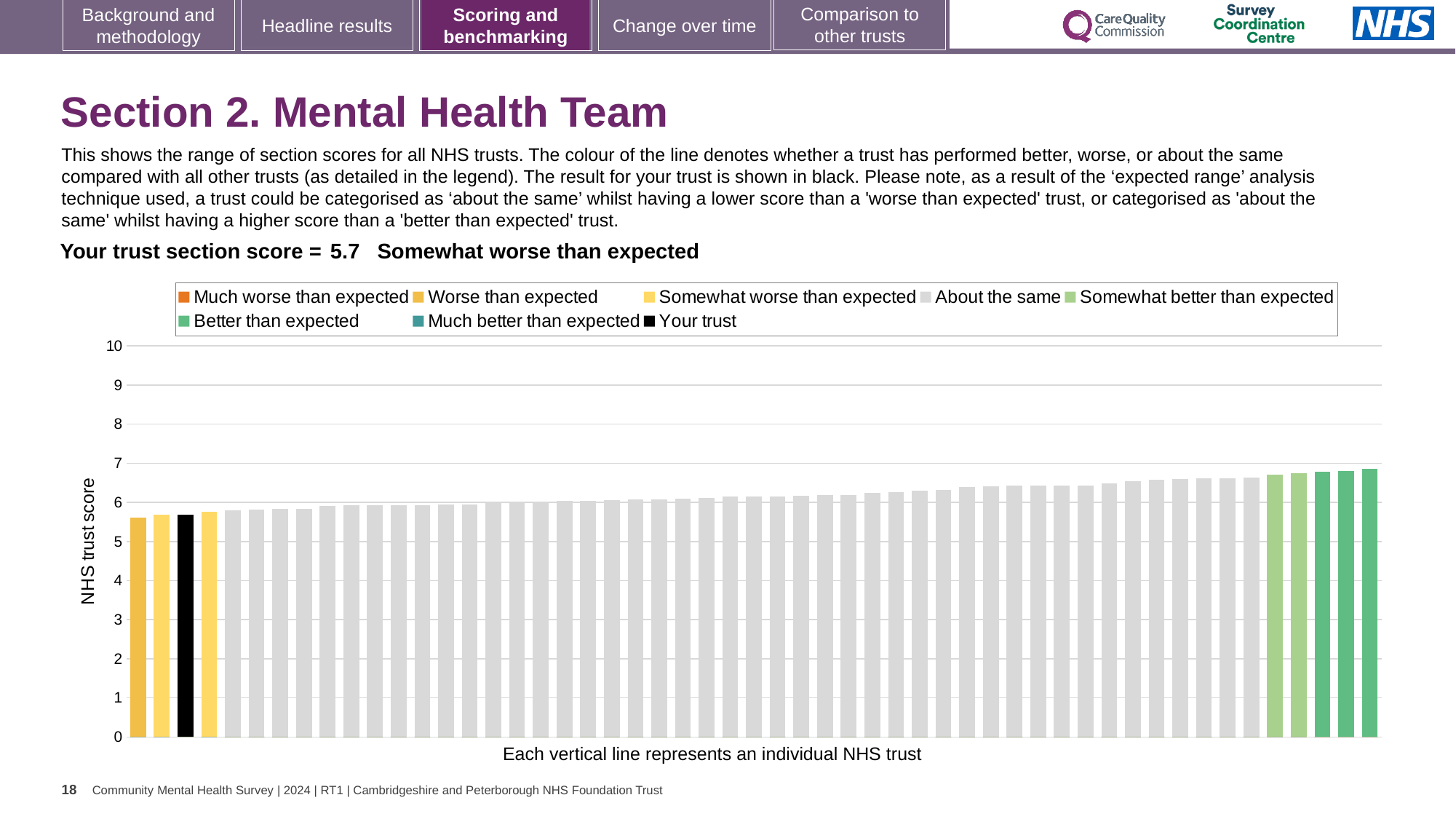
Is the tallest bar in the chart greater or less than 7? less Is the value for your trust greater or less than 6? less Which benchmarking category is your trust placed in for this section? Somewhat worse than expected What is the section score for your trust shown on the slide? 5.7 Is the shortest bar in the chart greater or less than 5? greater What colour is used for the bar representing your trust? black What kind of chart is shown on the slide? bar chart Do the bar values rise or fall from left to right along the x axis? rise How many entries does the chart legend list? 8 Is the bar for your trust higher or lower than the rightmost bar in the chart? lower What is the title of the vertical axis? NHS trust score